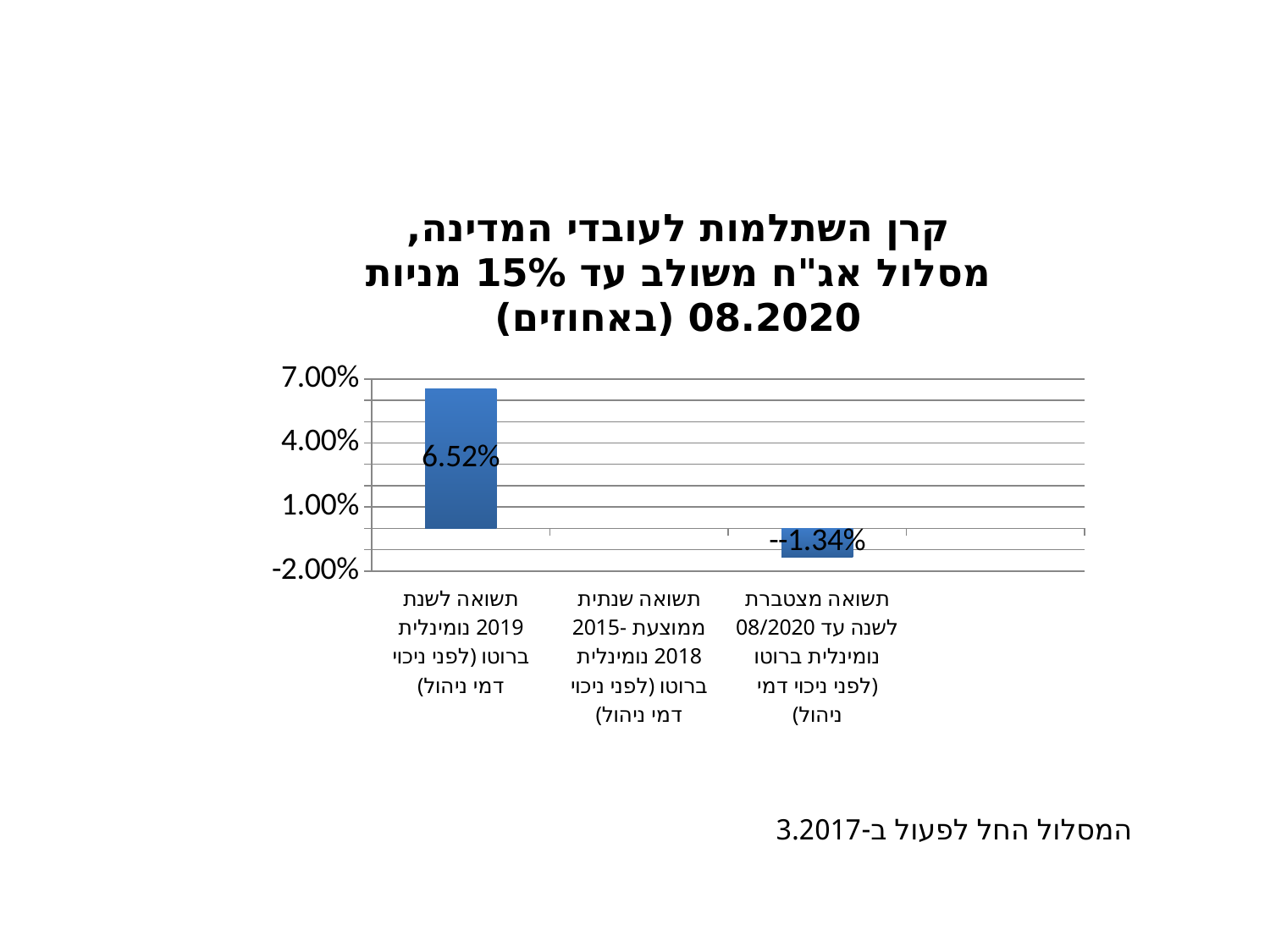
What is the value for the cumulative return for the year to 08/2020 (תשואה מצטברת לשנה עד 08/2020)? -1.34% What is the difference between the 2019 return (6.52%) and the cumulative return to 08/2020 (-1.34%)? 7.86% Is the value for the cumulative return to 08/2020 greater or less than 1.00%? less Is the value for the 2019 return greater or less than 4.00%? greater Which plotted category has the lowest value? תשואה מצטברת לשנה עד 08/2020 נומינלית ברוטו (לפני ניכוי דמי ניהול) How many bars are actually plotted in the chart? 2 What is the value for the 2019 return (תשואה לשנת 2019 נומינלית ברוטו)? 6.52% What kind of chart is shown on the slide? Bar chart Which is larger: the 2019 return or the cumulative return to 08/2020? The 2019 return Which category has the highest value? תשואה לשנת 2019 נומינלית ברוטו (לפני ניכוי דמי ניהול) How many categories are shown on the x axis? 3 Which category has no bar plotted? תשואה שנתית ממוצעת 2015-2018 נומינלית ברוטו (לפני ניכוי דמי ניהול)